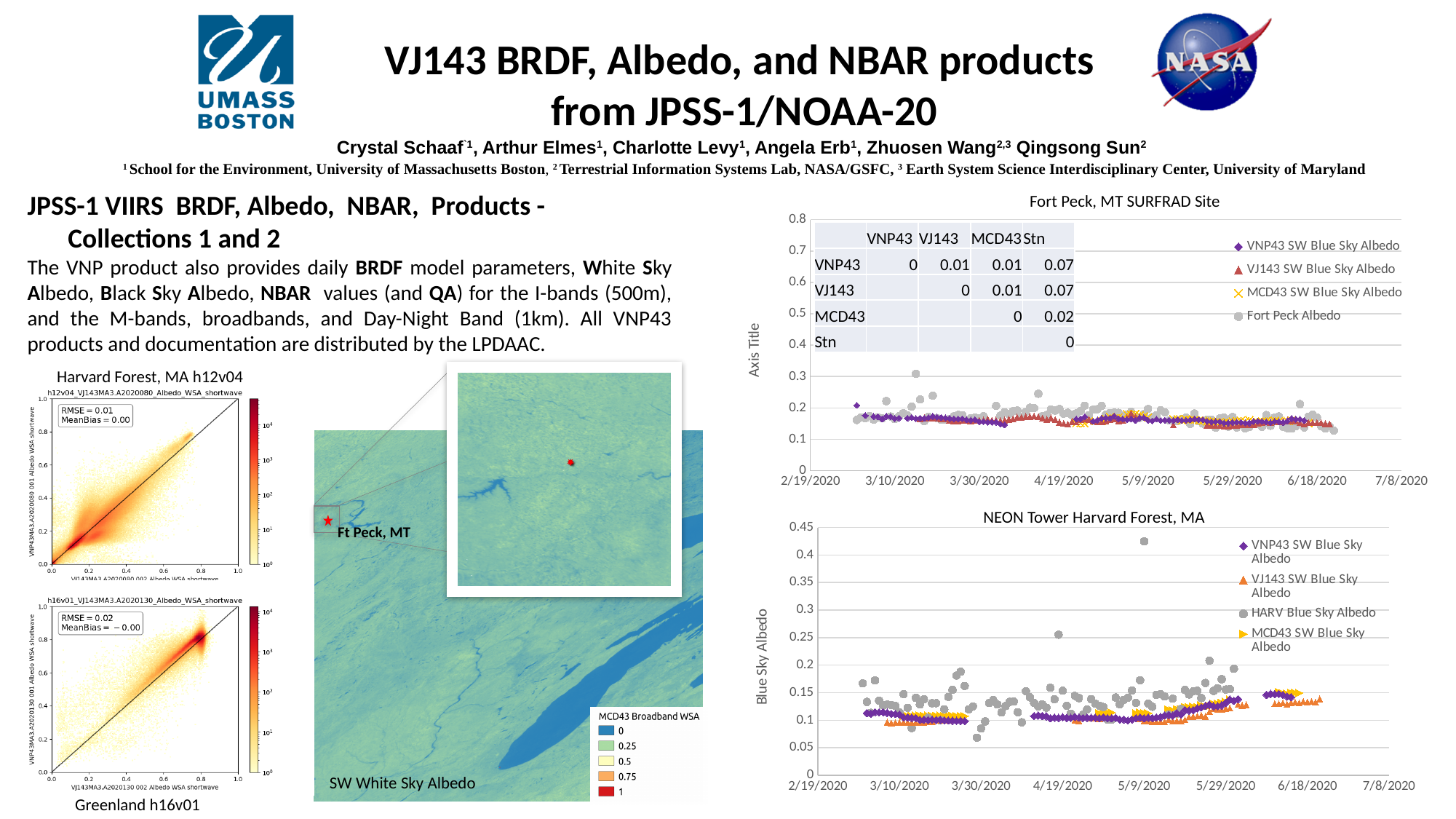
In the Fort Peck, MT SURFRAD Site chart, what is the maximum value shown on the y axis? 0.8 What kind of chart is the NEON Tower Harvard Forest, MA chart? Scatter chart In the table on the Fort Peck, MT SURFRAD Site chart, what is the value for VNP43 versus Stn? 0.07 In the Fort Peck, MT SURFRAD Site chart, how many series does the legend list? 4 In the NEON Tower Harvard Forest, MA chart, how many series does the legend list? 4 In the table on the Fort Peck, MT SURFRAD Site chart, which is larger: the VJ143 versus Stn value or the MCD43 versus Stn value? VJ143 versus Stn In the table on the Fort Peck, MT SURFRAD Site chart, what is the value for MCD43 versus Stn? 0.02 In the Harvard Forest, MA h12v04 scatter plot, what RMSE value is printed? 0.01 What is the y-axis title of the NEON Tower Harvard Forest, MA chart? Blue Sky Albedo In the NEON Tower Harvard Forest, MA chart, is the highest HARV Blue Sky Albedo point greater or less than 0.4? greater In the table on the Fort Peck, MT SURFRAD Site chart, what is the value for VNP43 versus VJ143? 0.01